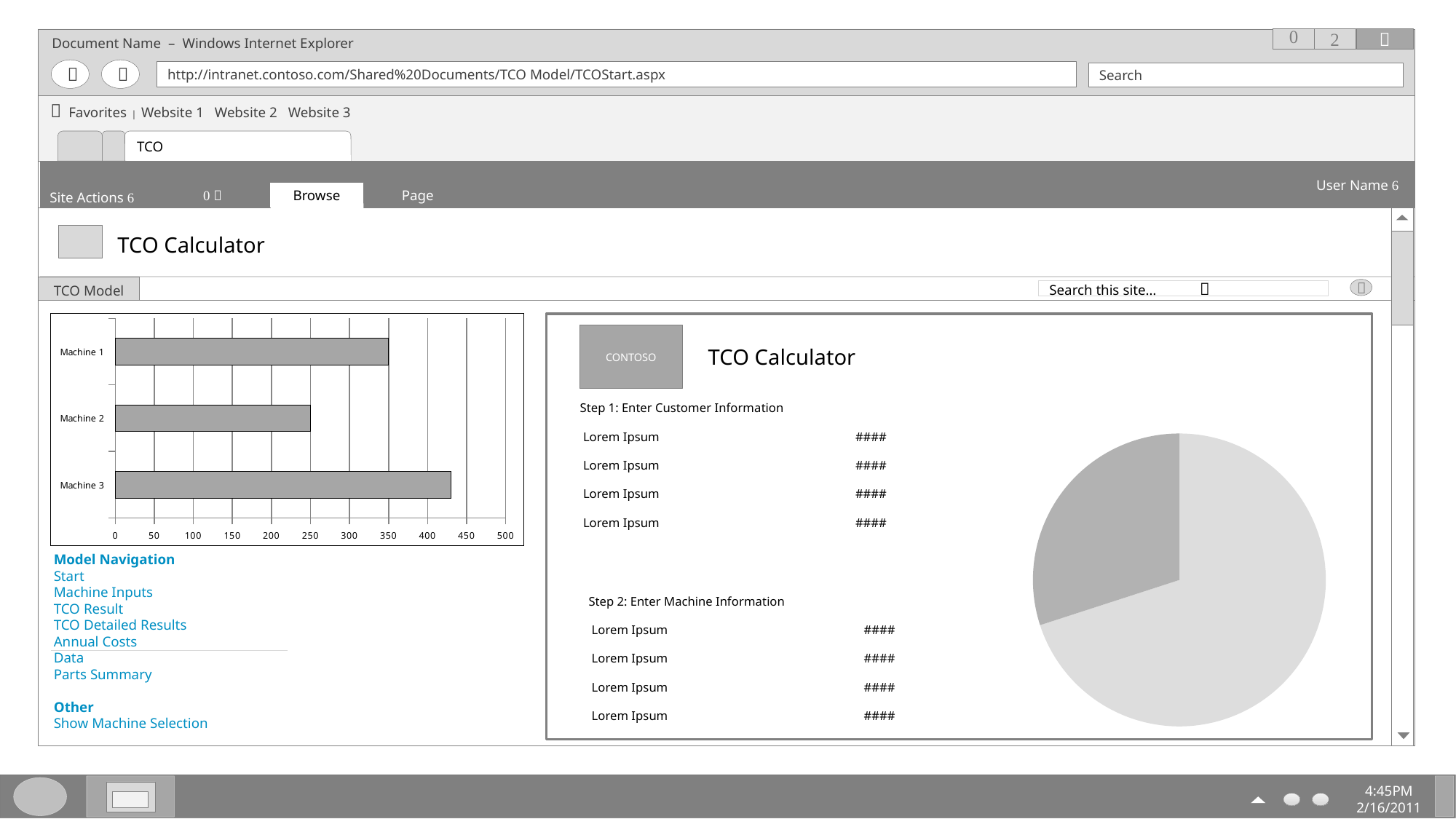
In the bar chart on the left, how many machines are plotted? 3 In the bar chart on the left, is the value for Machine 3 greater or less than 400? greater What kind of chart is shown on the right side of the slide, inside the TCO Calculator panel? pie chart What kind of chart is shown on the left side of the slide? bar chart How many slices does the pie chart on the right have? 2 In the bar chart on the left, which machine has the highest value? Machine 3 In the bar chart on the left, is the value for Machine 2 greater or less than 300? less In the bar chart on the left, what is the value for Machine 1? 350 In the bar chart on the left, what is the value for Machine 2? 250 In the bar chart on the left, which is larger, the value for Machine 1 or Machine 3? Machine 3 In the bar chart on the left, what is the difference between the values for Machine 1 and Machine 2? 100 In the bar chart on the left, which machine has the lowest value? Machine 2